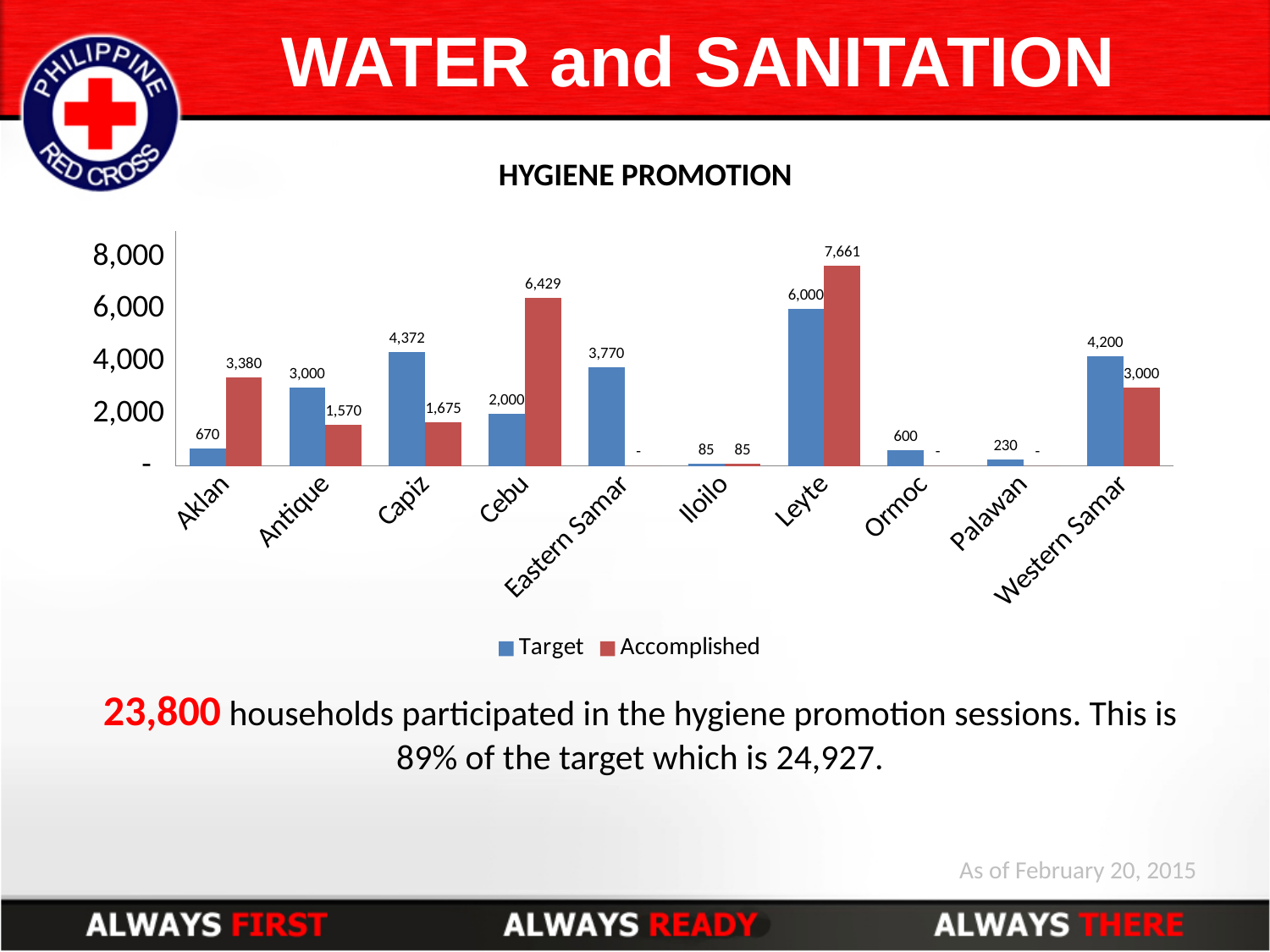
What is the Target value for Leyte? 6,000 What is the Accomplished value for Cebu? 6,429 Is the Target value for Western Samar greater or less than 4,000? greater How many series does the legend list? 2 How many provinces are shown on the x axis? 10 What is the difference between the Accomplished and Target values for Leyte? 1,661 Which is larger for Capiz, the Target or the Accomplished value? Target What is the Accomplished value for Aklan? 3,380 Which province has the lowest Target value? Iloilo Which province has the highest Accomplished value? Leyte What is the title of the chart? HYGIENE PROMOTION What kind of chart is shown? bar chart